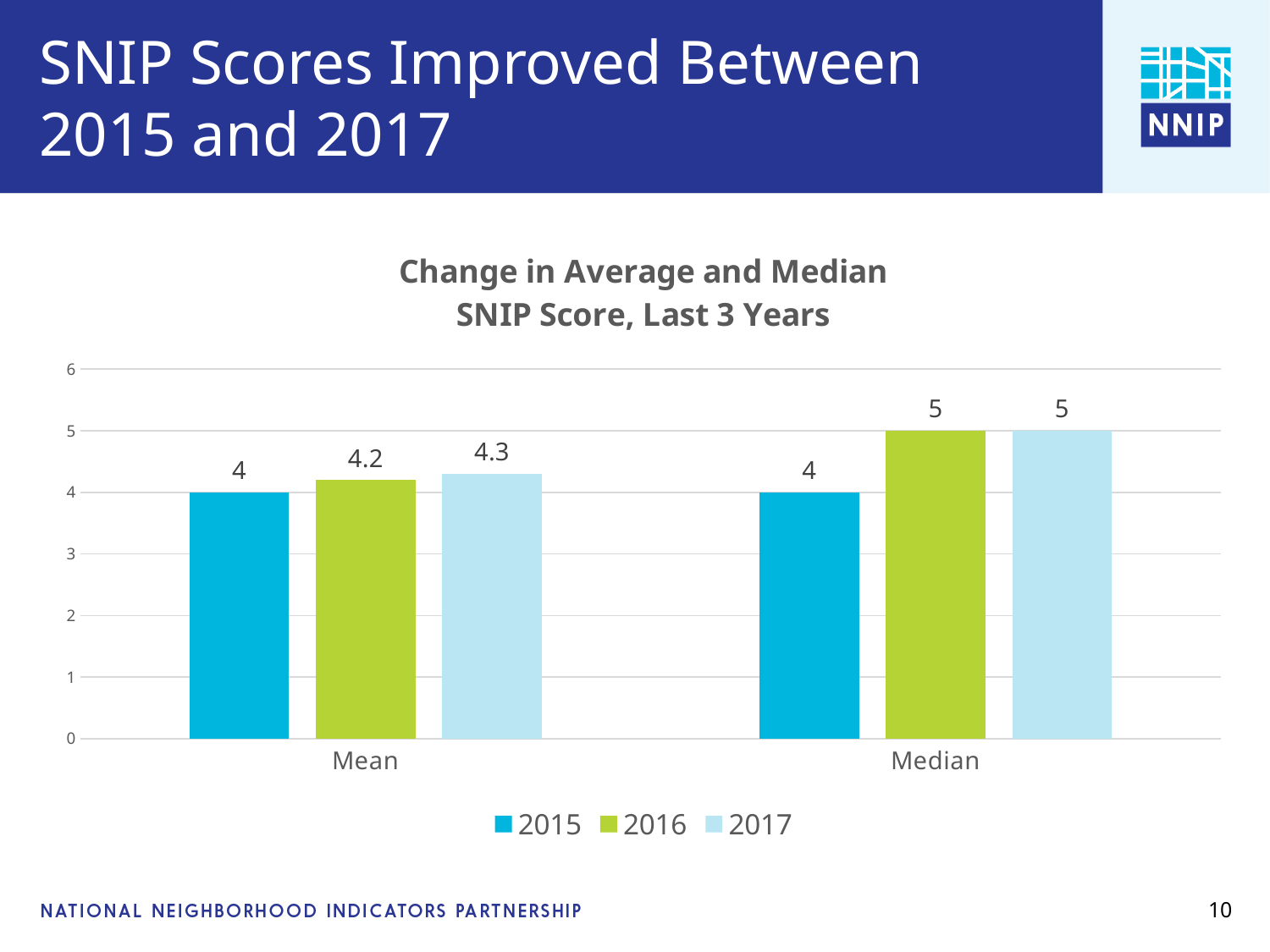
Which year has the highest Mean SNIP score? 2017 Which year has the lowest Median SNIP score? 2015 What kind of chart is shown on the slide? Bar chart What is the Median SNIP score for 2016? 5 Which is larger, the Mean SNIP score for 2016 or for 2015? 2016 What is the Mean SNIP score for 2015? 4 What is the title of the chart? Change in Average and Median SNIP Score, Last 3 Years What is the Median SNIP score for 2015? 4 What is the difference between the Mean SNIP score in 2017 and in 2015? 0.3 What is the Mean SNIP score for 2017? 4.3 How many series does the legend list? 3 How many categories are shown on the x axis? 2